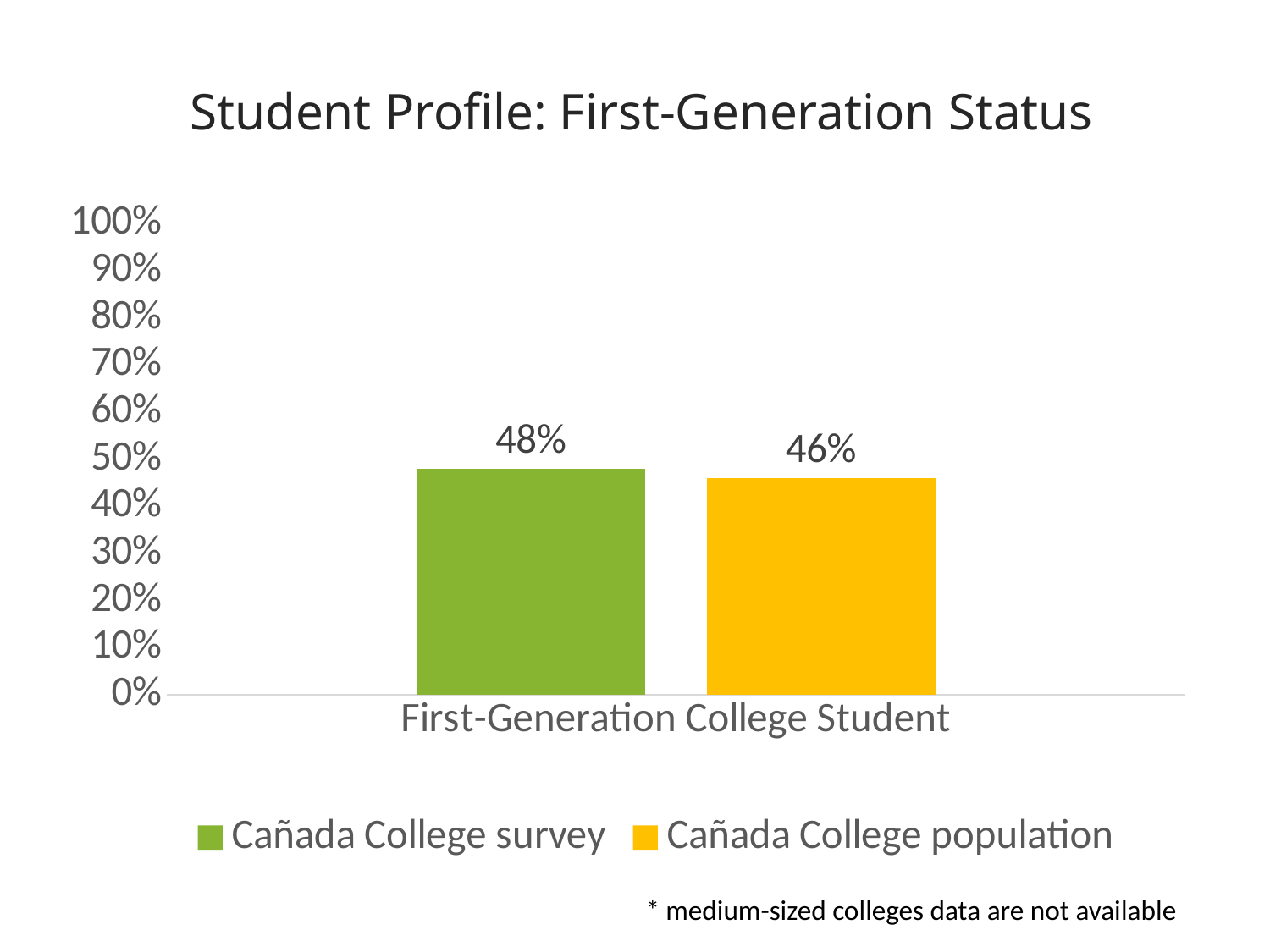
What is the title of the chart? Student Profile: First-Generation Status Which series has the lowest value for First-Generation College Student? Cañada College population How many categories are shown on the x axis? 1 What is the difference between the Cañada College survey value and the Cañada College population value? 2% What is the value for Cañada College survey for First-Generation College Student? 48% Which series has the higher value for First-Generation College Student: Cañada College survey or Cañada College population? Cañada College survey Which series is shown in green? Cañada College survey What kind of chart is shown on the slide? bar chart How many series does the legend list? 2 What is the value for Cañada College population for First-Generation College Student? 46% Is the value for Cañada College survey greater or less than 50%? less Is the value for Cañada College population greater or less than 40%? greater